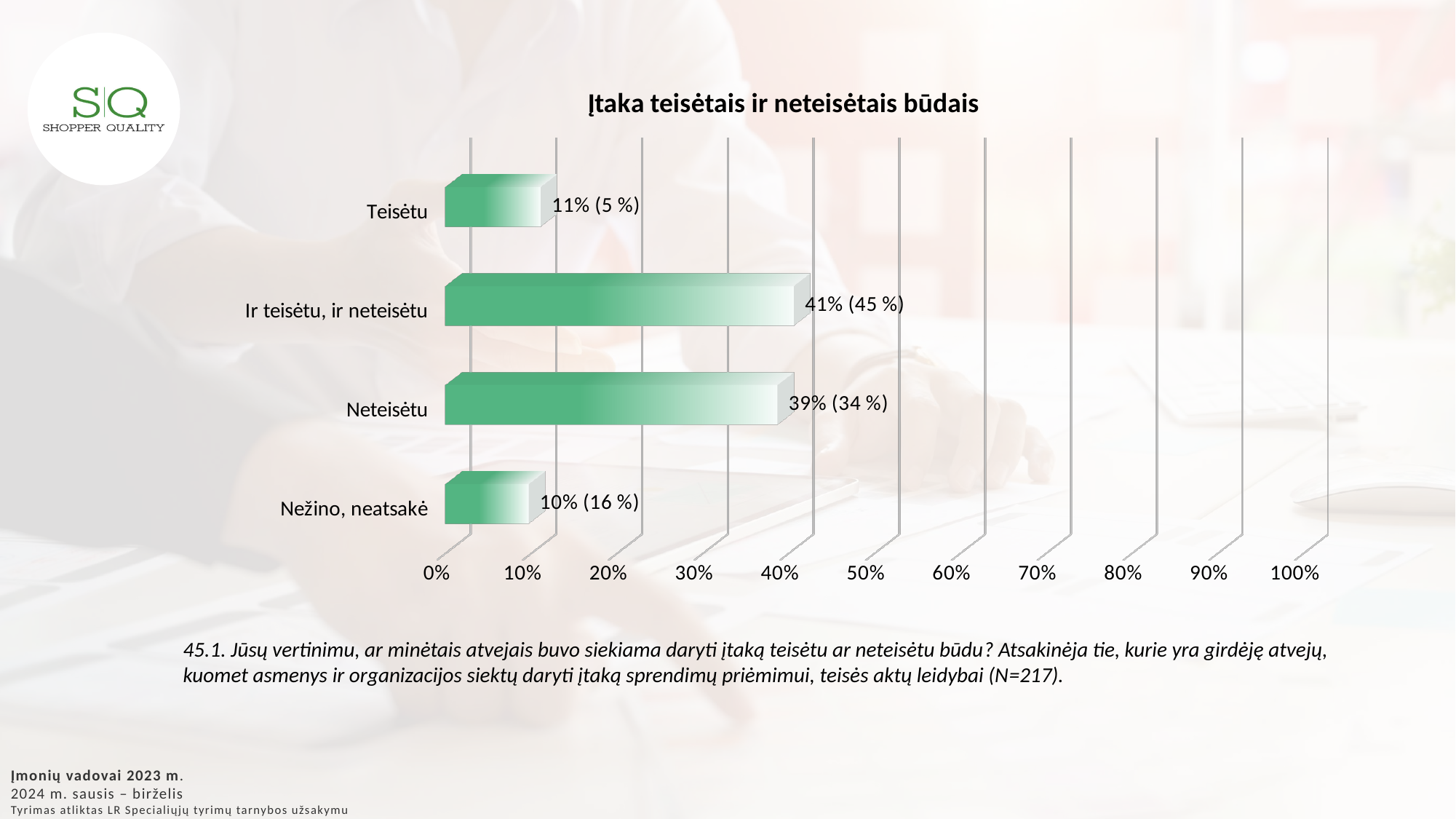
What is the title of the chart? Įtaka teisėtais ir neteisėtais būdais Which is larger, the value for "Teisėtu" or the value for "Neteisėtu"? Neteisėtu What is the main percentage shown for "Neteisėtu"? 39% What is the difference in percentage points between "Ir teisėtu, ir neteisėtu" (41%) and "Neteisėtu" (39%)? 2 What is the data label printed for "Ir teisėtu, ir neteisėtu"? 41% (45 %) What is the data label printed for "Teisėtu"? 11% (5 %) What kind of chart is shown on the slide? bar chart How many categories does the chart show? 4 Which category has the highest value? Ir teisėtu, ir neteisėtu Is the value for "Neteisėtu" greater or less than 30%? greater Which category has the lowest value? Nežino, neatsakė What is the main percentage shown for "Nežino, neatsakė"? 10%